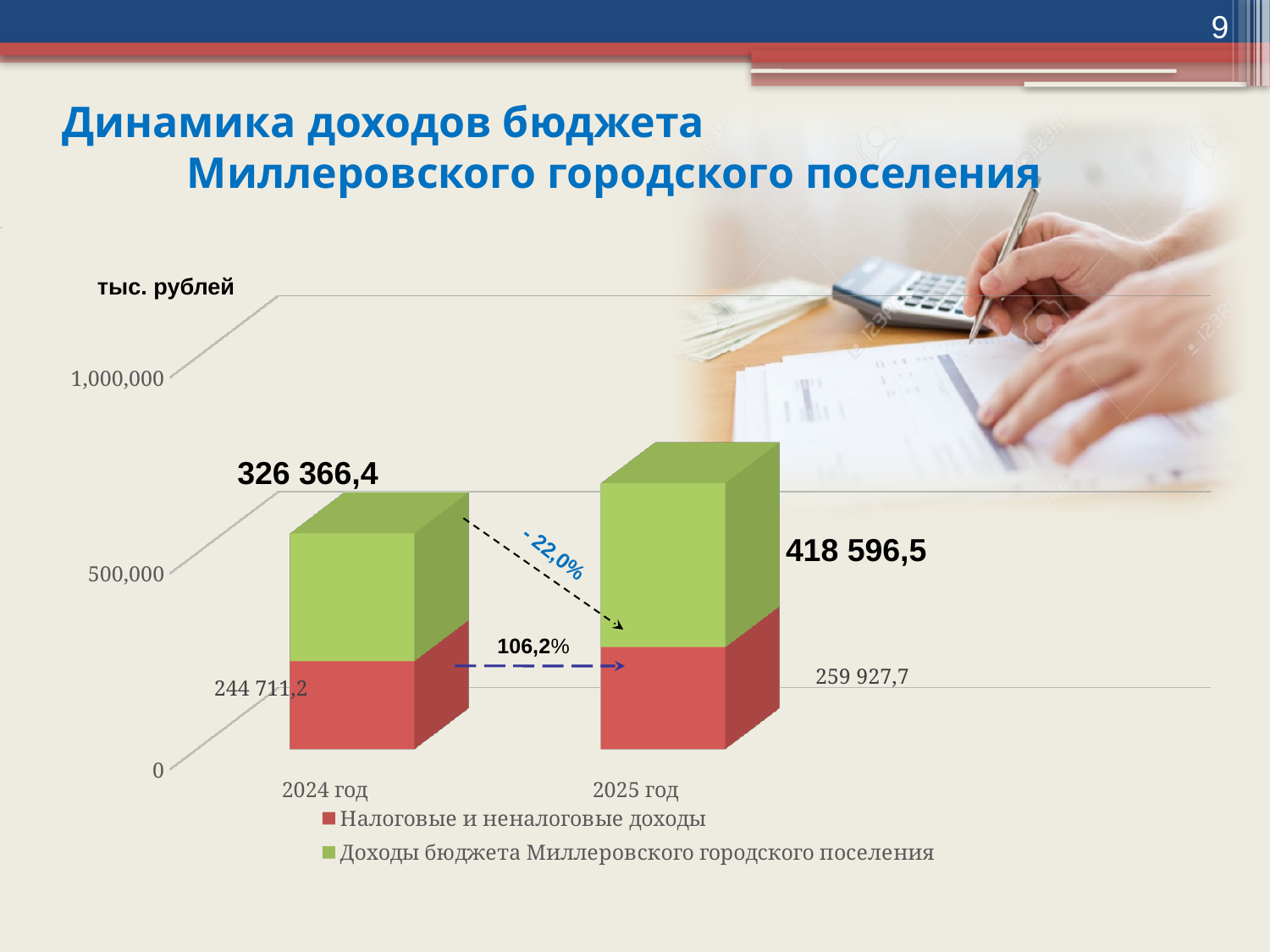
By how much does the labelled value 418 596,5 for 2025 год exceed the labelled value 326 366,4 for 2024 год? 92 230,1 What is the value of 'Налоговые и неналоговые доходы' for 2025 год? 259 927,7 What is the value of 'Налоговые и неналоговые доходы' for 2024 год? 244 711,2 How many series does the chart legend list? 2 Is the total height of the stacked bar for 2024 год greater or less than 500,000? greater What type of chart is shown on the slide? stacked bar chart What percentage is shown on the dashed blue arrow between the two bars? 106,2% How many categories (years) are shown on the x axis of the chart? 2 What value is labelled for 'Доходы бюджета Миллеровского городского поселения' in 2024 год? 326 366,4 What value is labelled for 'Доходы бюджета Миллеровского городского поселения' in 2025 год? 418 596,5 Which year has the higher value for 'Налоговые и неналоговые доходы', 2024 год or 2025 год? 2025 год What is the difference between 'Налоговые и неналоговые доходы' in 2025 год and in 2024 год? 15 216,5